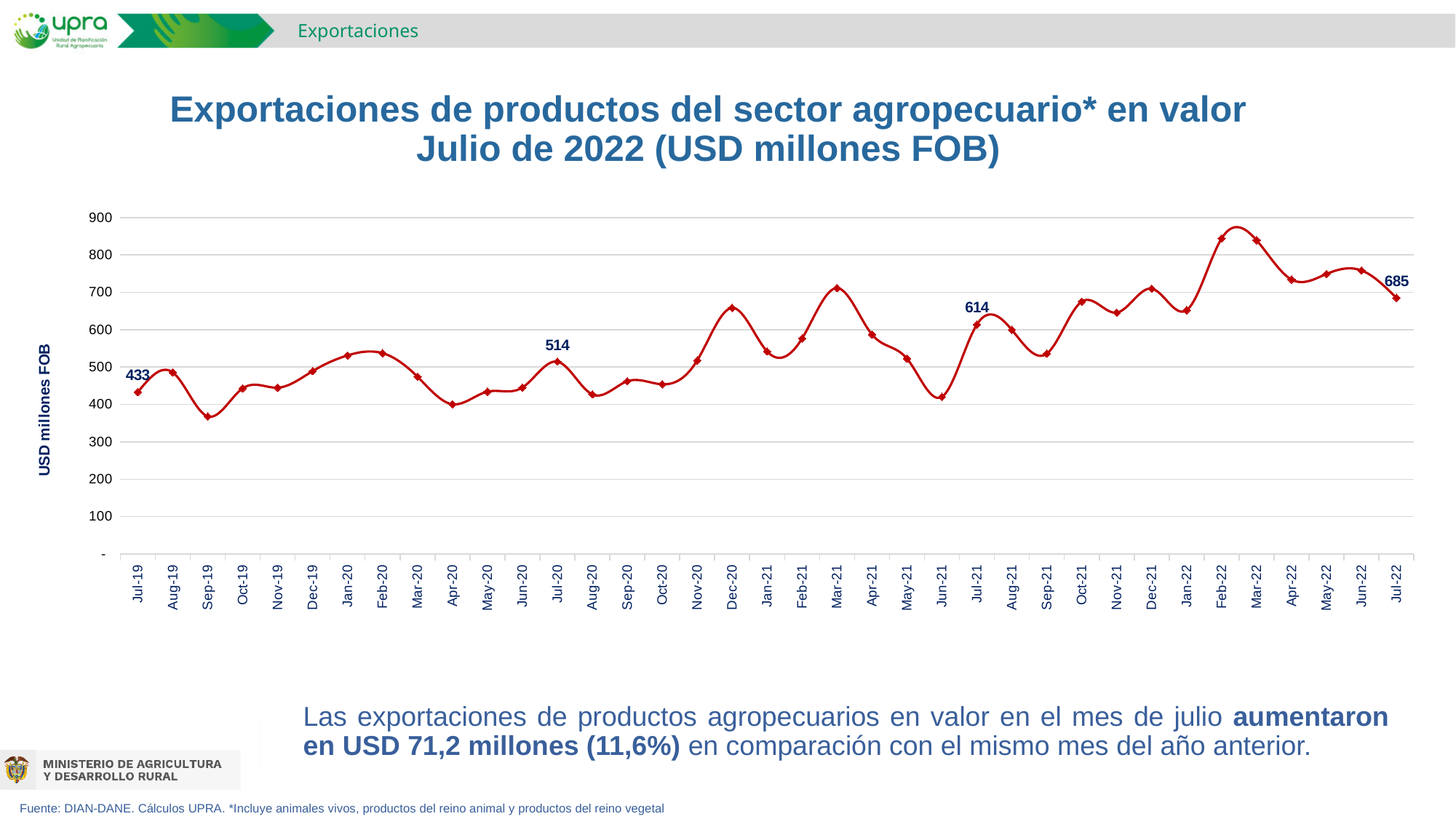
Which month has the lowest value on the chart? Sep-19 What is the value for Jul-21? 614 What is the value for Jul-19? 433 Is the value for Dec-20 greater or less than 600? greater What type of chart is shown on the slide? line chart Is the value for Sep-19 greater or less than 400? less Which is larger, the value for Jul-22 or the value for Jul-19? Jul-22 What is the difference between the values for Jul-22 and Jul-21? 71 What is the value for Jul-22? 685 What is the value for Jul-20? 514 What is the difference between the values for Jul-21 and Jul-20? 100